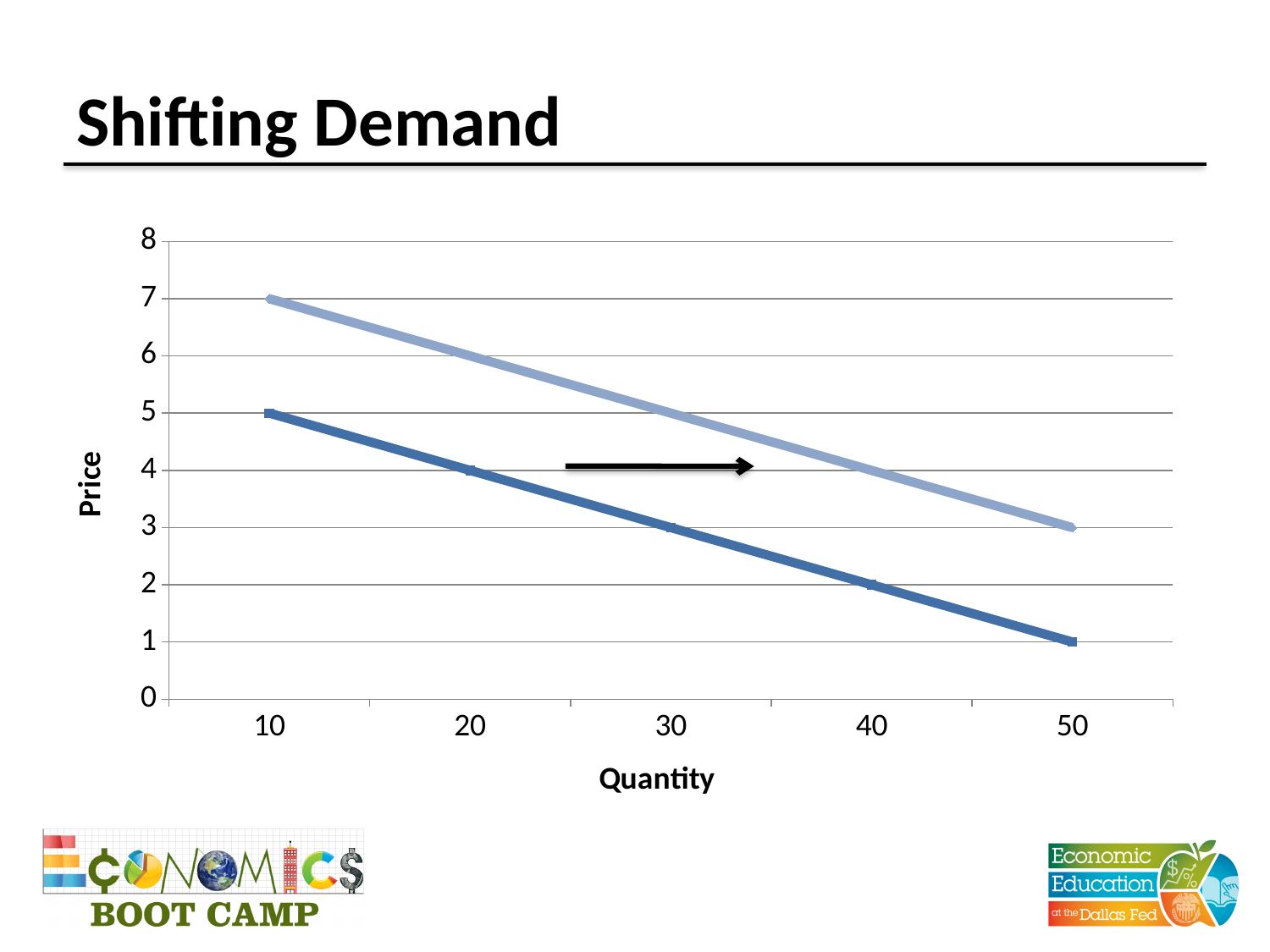
How many lines are plotted on the chart? 2 What is the label of the vertical axis? Price What is the price on the lighter blue line at a quantity of 10? 7 What is the price on the darker blue line at a quantity of 30? 3 What is the title of the chart? Shifting Demand What is the difference in price between the lighter blue line and the darker blue line at a quantity of 30? 2 What is the price on the darker blue line at a quantity of 10? 5 What type of chart is shown on the slide? line chart What is the price on the lighter blue line at a quantity of 50? 3 Do the prices on the lines rise or fall as quantity increases? fall At a quantity of 10, which line has the higher price, the darker blue or the lighter blue? lighter blue What is the price on the darker blue line at a quantity of 50? 1